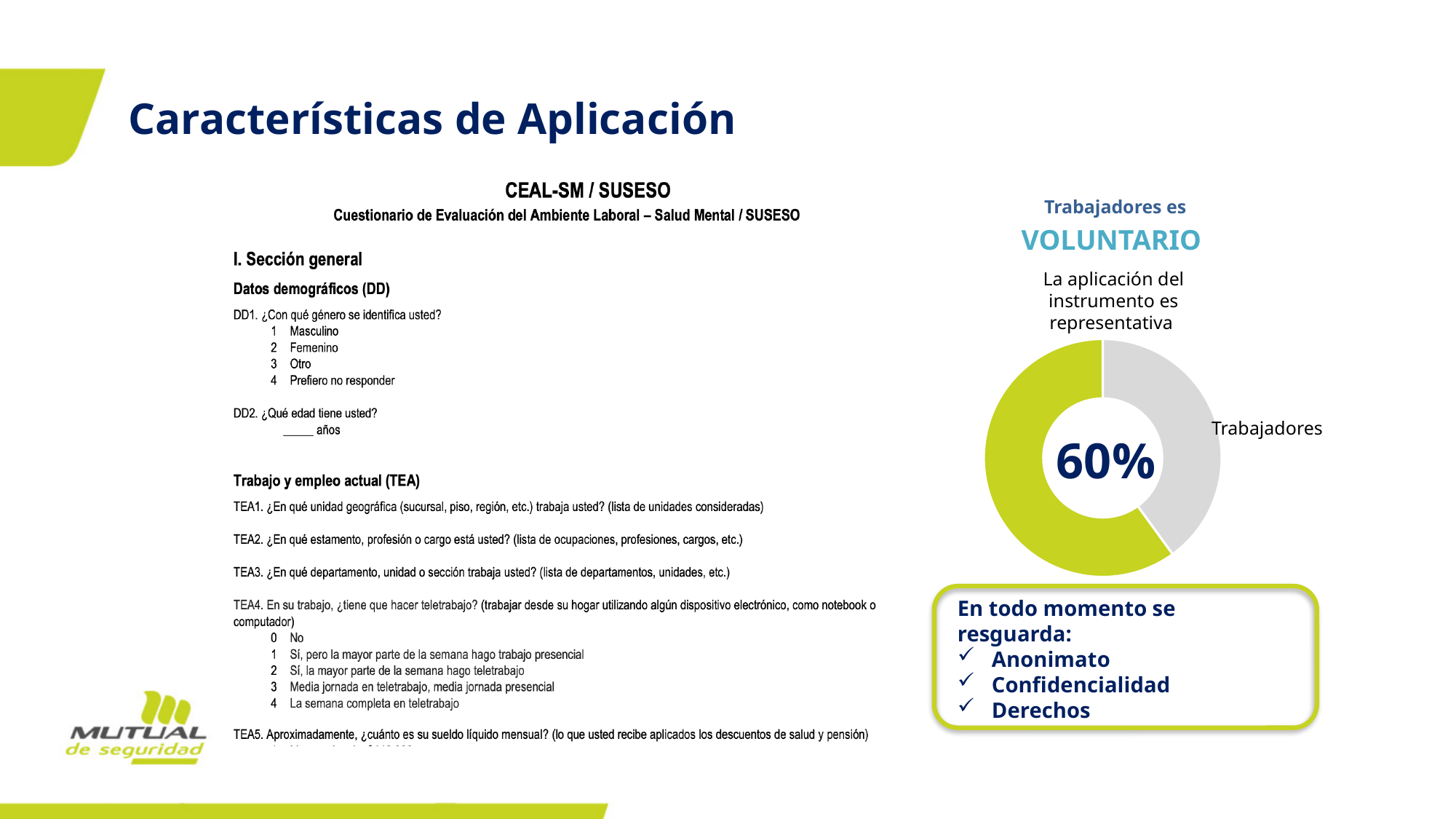
How many slices does the doughnut chart have? 2 What label appears next to the grey slice of the doughnut chart? Trabajadores Which slice of the doughnut chart is larger, the green one or the grey one? the green one What text appears directly above the doughnut chart? La aplicación del instrumento es representativa What kind of chart is shown on the right side of the slide? doughnut chart What percentage is printed in the centre of the doughnut chart? 60%